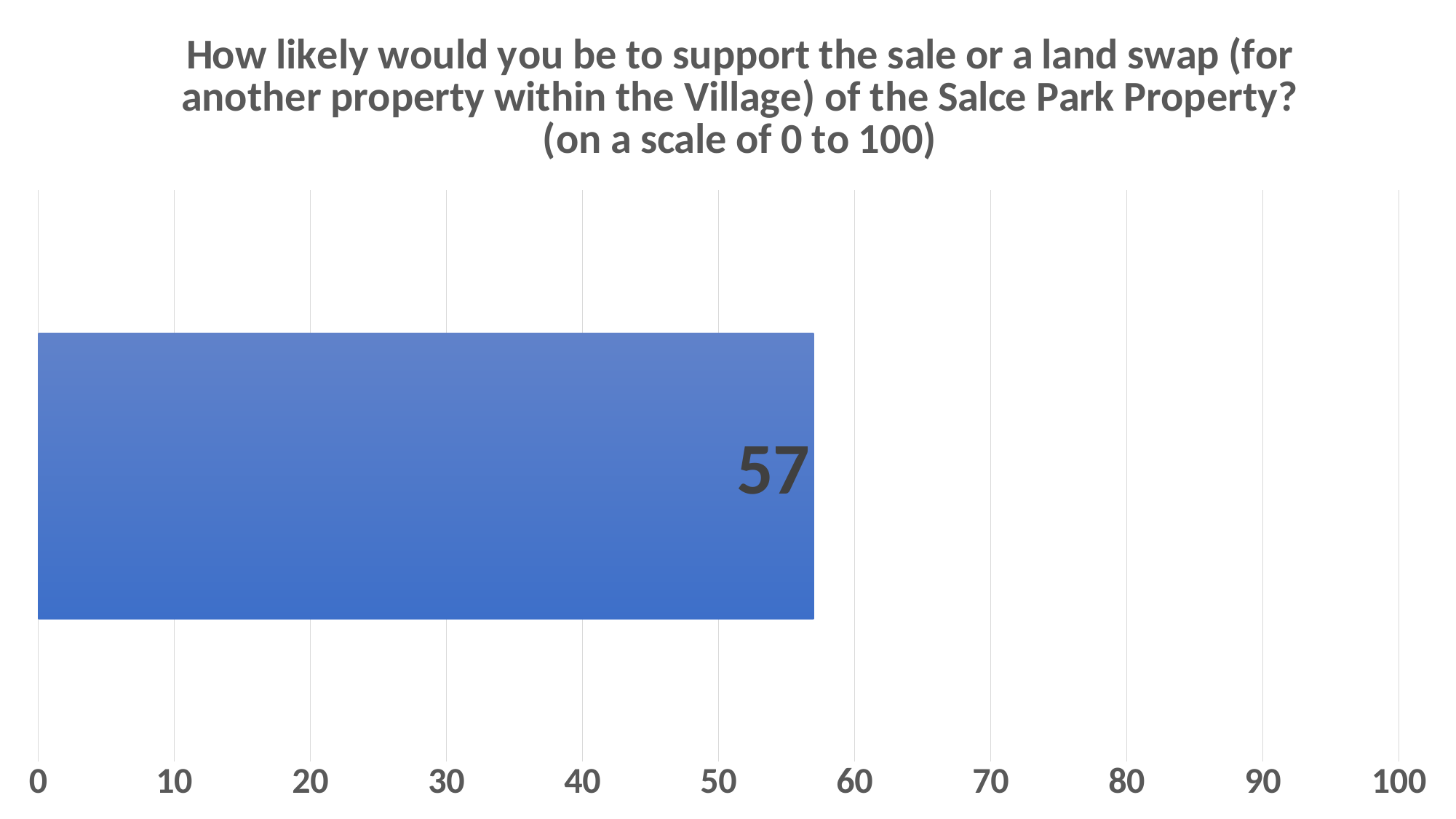
Is the value shown on the bar greater or less than 60? less What is the maximum value shown on the horizontal axis? 100 Is the value shown on the bar greater or less than 100? less What value is shown on the bar in the chart? 57 What kind of chart is shown on the slide? bar chart Is the value shown on the bar greater or less than 50? greater What scale does the chart title say the question was asked on? 0 to 100 How many bars are plotted in the chart? 1